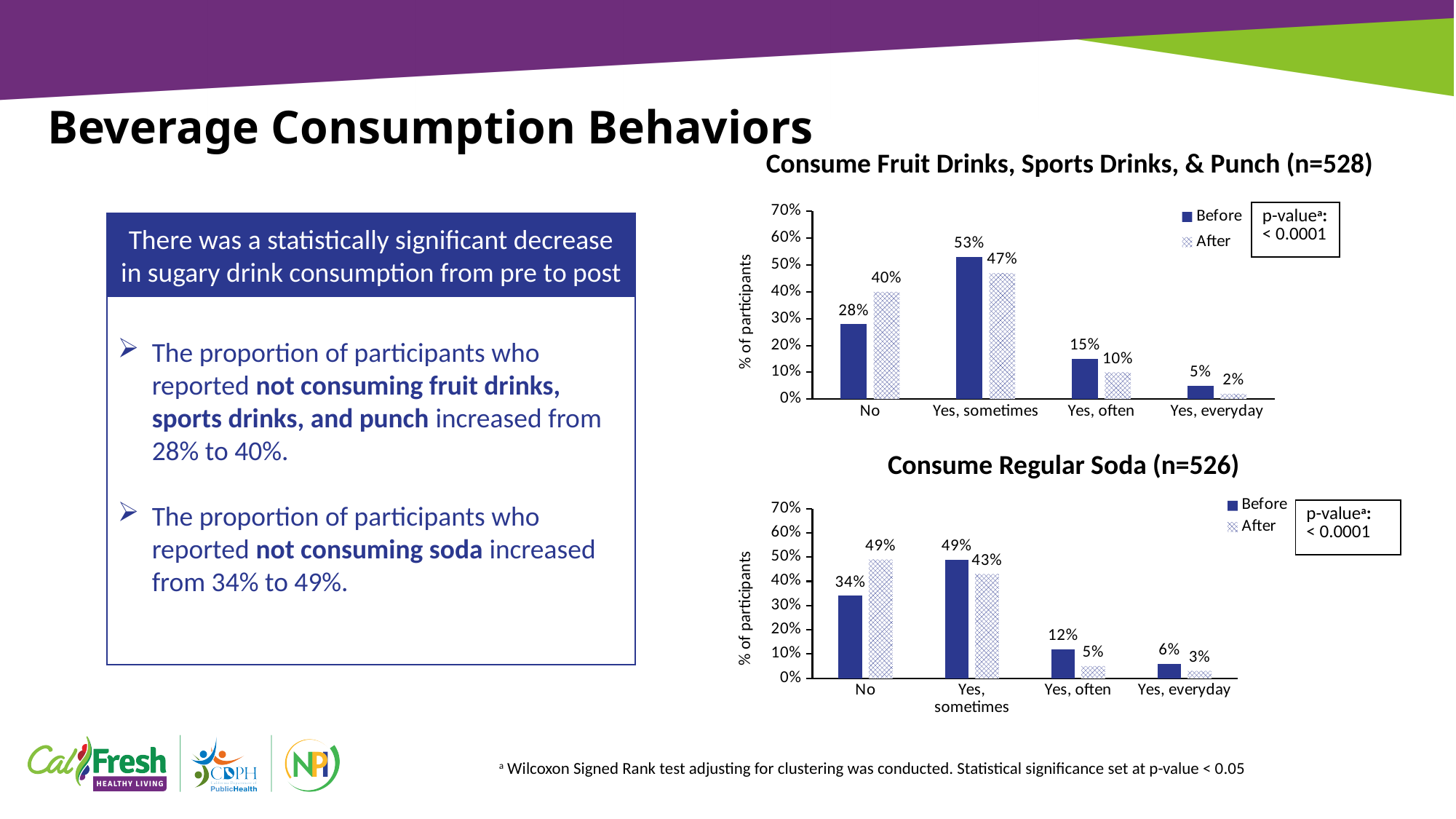
In the 'Consume Fruit Drinks, Sports Drinks, & Punch (n=528)' chart, what is the Before value for 'No'? 28% What type of chart is the 'Consume Fruit Drinks, Sports Drinks, & Punch (n=528)' chart? Bar chart In the 'Consume Fruit Drinks, Sports Drinks, & Punch (n=528)' chart, how many series does the legend list? 2 In the 'Consume Fruit Drinks, Sports Drinks, & Punch (n=528)' chart, which category has the highest Before value? Yes, sometimes In the 'Consume Regular Soda (n=526)' chart, what is the Before value for 'Yes, everyday'? 6% In the 'Consume Regular Soda (n=526)' chart, is the Before value for 'No' larger or the After value for 'No'? After How many categories are shown on the x axis of the 'Consume Regular Soda (n=526)' chart? 4 In the 'Consume Regular Soda (n=526)' chart, what is the difference between the Before and After values for 'Yes, sometimes'? 6% In the 'Consume Regular Soda (n=526)' chart, which category has the lowest After value? Yes, everyday In the 'Consume Regular Soda (n=526)' chart, what is the After value for 'No'? 49% In the 'Consume Fruit Drinks, Sports Drinks, & Punch (n=528)' chart, what is the After value for 'Yes, sometimes'? 47% In the 'Consume Fruit Drinks, Sports Drinks, & Punch (n=528)' chart, what is the difference between the Before and After values for 'Yes, often'? 5%